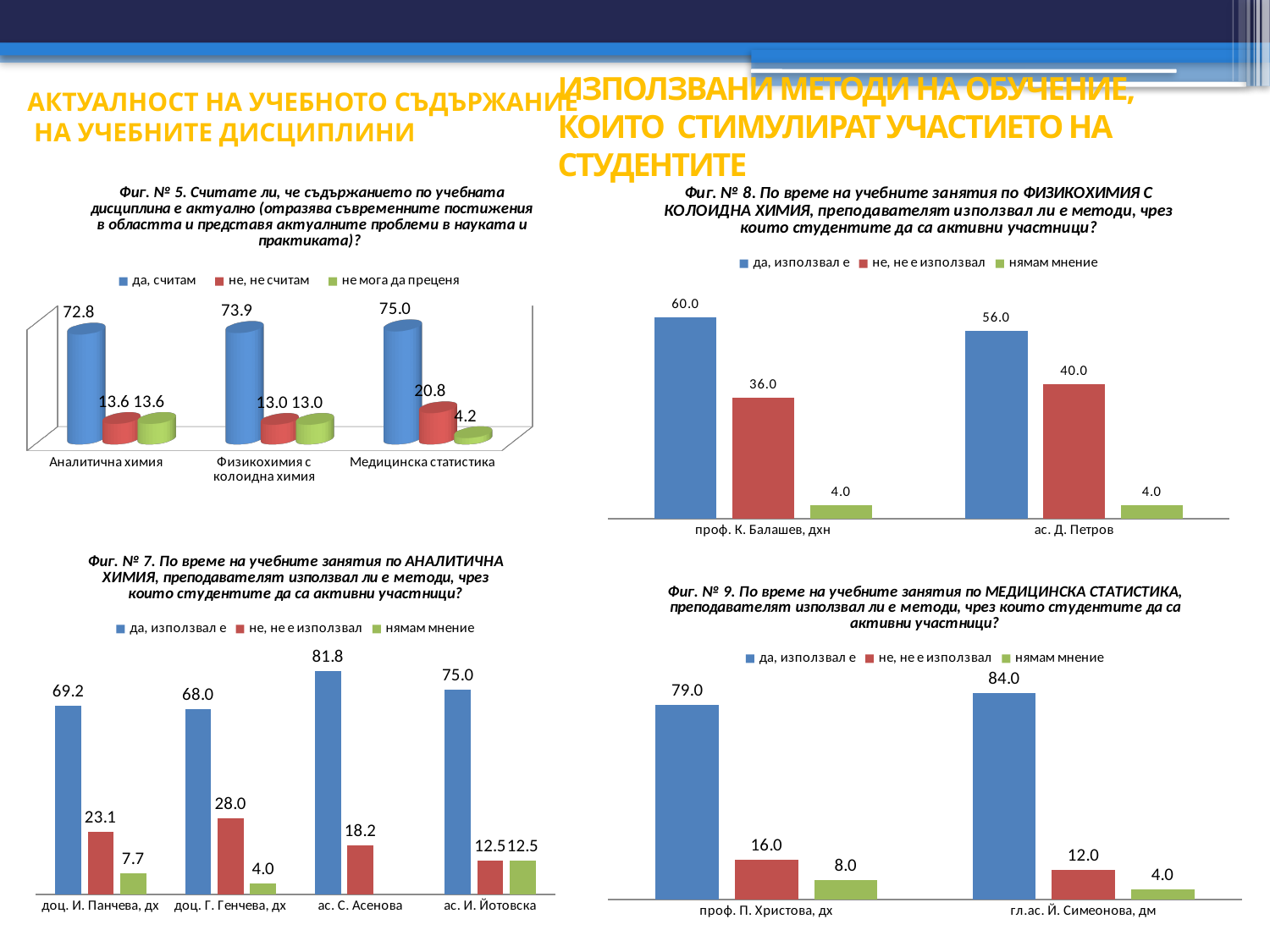
In the chart titled Фиг. № 7, what is the value of 'не, не е използвал' for доц. Г. Генчева, дх? 28.0 In the chart titled Фиг. № 5, what is the value of 'да, считам' for Медицинска статистика? 75.0 In the chart titled Фиг. № 9, what is the value of 'да, използвал е' for гл.ас. Й. Симеонова, дм? 84.0 In the chart titled Фиг. № 7, what is the difference between 'да, използвал е' for ас. С. Асенова and for доц. Г. Генчева, дх? 13.8 In the chart titled Фиг. № 5, how many categories are shown on the x axis? 3 In the chart titled Фиг. № 7, which category has the highest value for 'да, използвал е'? ас. С. Асенова In the chart titled Фиг. № 8, which is larger: 'да, използвал е' for проф. К. Балашев, дхн or for ас. Д. Петров? проф. К. Балашев, дхн In the chart titled Фиг. № 8, how many series does the legend list? 3 In the chart titled Фиг. № 9, what is the difference between 'не, не е използвал' for проф. П. Христова, дх and for гл.ас. Й. Симеонова, дм? 4.0 In the chart titled Фиг. № 5, what is the value of 'не мога да преценя' for Медицинска статистика? 4.2 What kind of chart is the chart titled Фиг. № 9? bar chart In the chart titled Фиг. № 8, what is the value of 'не, не е използвал' for ас. Д. Петров? 40.0